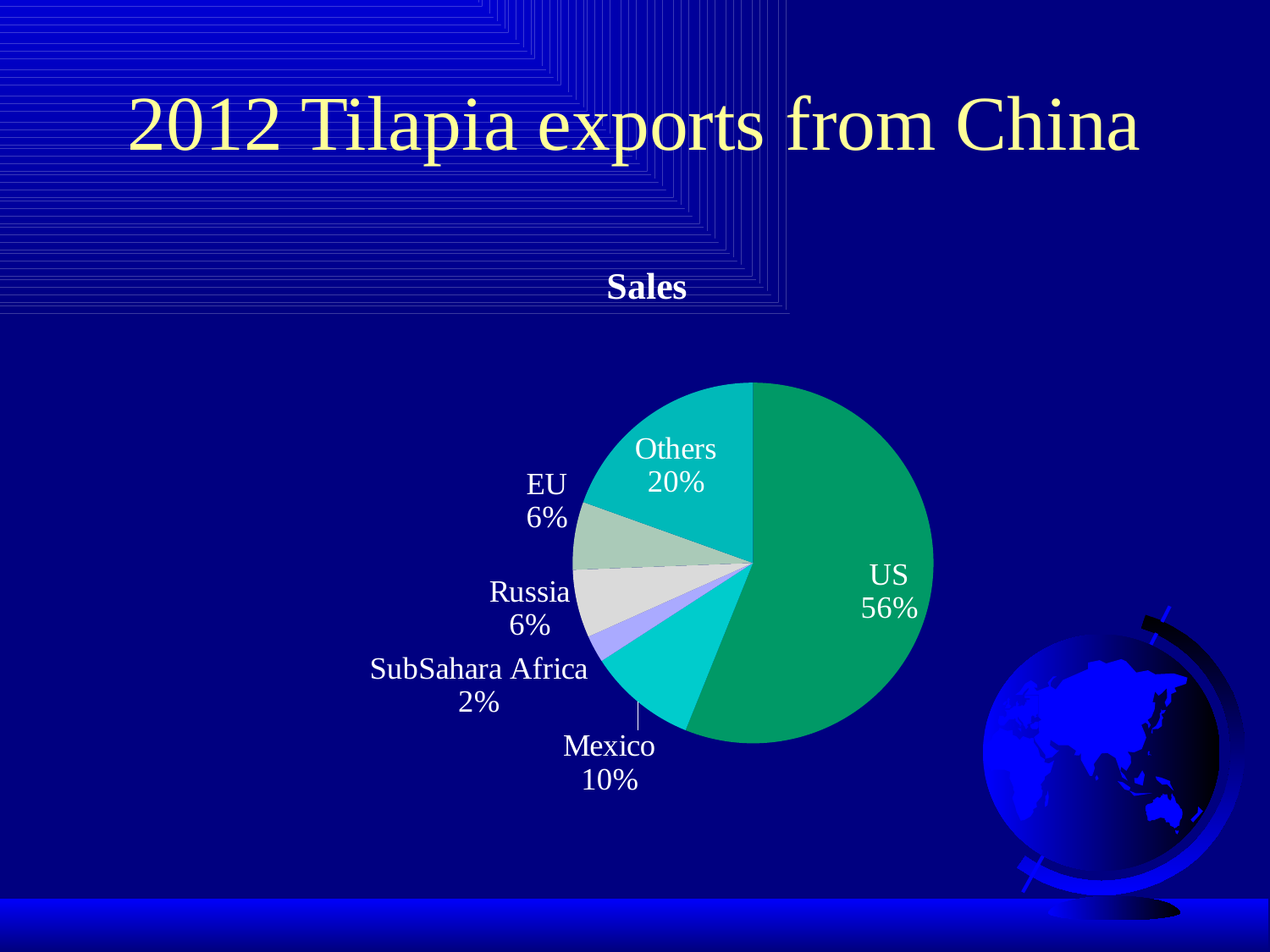
What share of the pie does the US slice have? 56% What is the value for Mexico? 10% What is the chart's title? Sales How many slices does the pie chart have? 6 What kind of chart is shown on the slide? pie chart Which category has the largest slice? US What is the value for Russia? 6% What is the value for SubSahara Africa? 2% Which is larger, the Mexico slice or the EU slice? Mexico Which category has the smallest slice? SubSahara Africa What share of the pie does the Others slice have? 20% What is the difference between the US share and the Others share? 36%